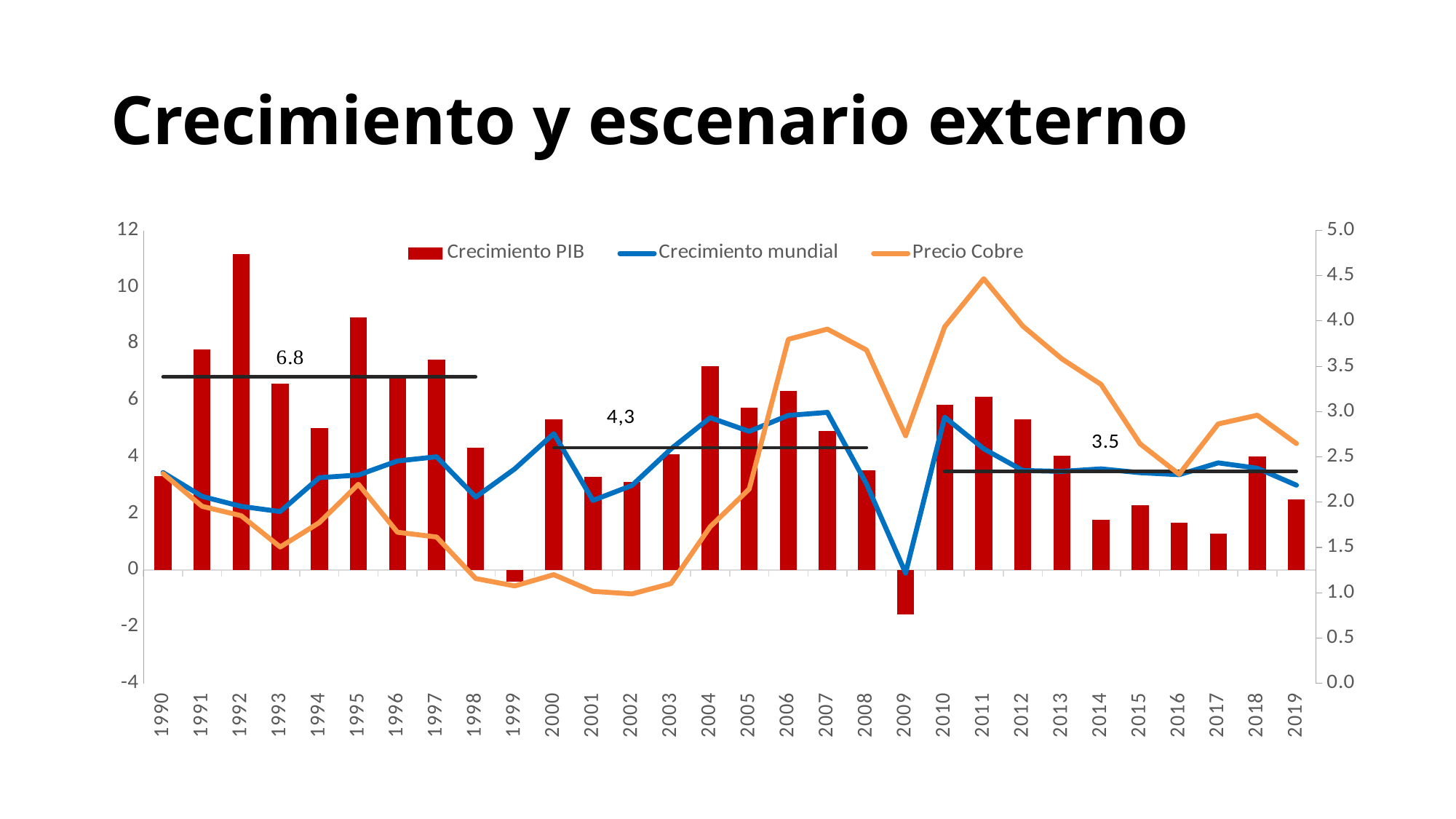
In which year is the Crecimiento PIB bar the highest? 1992 Is the Crecimiento PIB value for 2014 greater or less than 2? less Is the Crecimiento PIB value for 1992 greater or less than 10? greater In which year is the Crecimiento PIB bar the lowest? 2009 How many years are shown along the x axis? 30 What value is annotated above the horizontal line spanning the 1990s bars? 6.8 What value is annotated above the horizontal line spanning the 2010–2019 bars? 3.5 What kind of chart is shown on the slide? A combination bar and line chart Which year has the larger Crecimiento PIB bar, 1992 or 1995? 1992 Is the Precio Cobre value for 2011 greater or less than 4.0 on the right-hand axis? greater Which year has the higher Precio Cobre value, 2011 or 2016? 2011 How many series does the legend list? 3